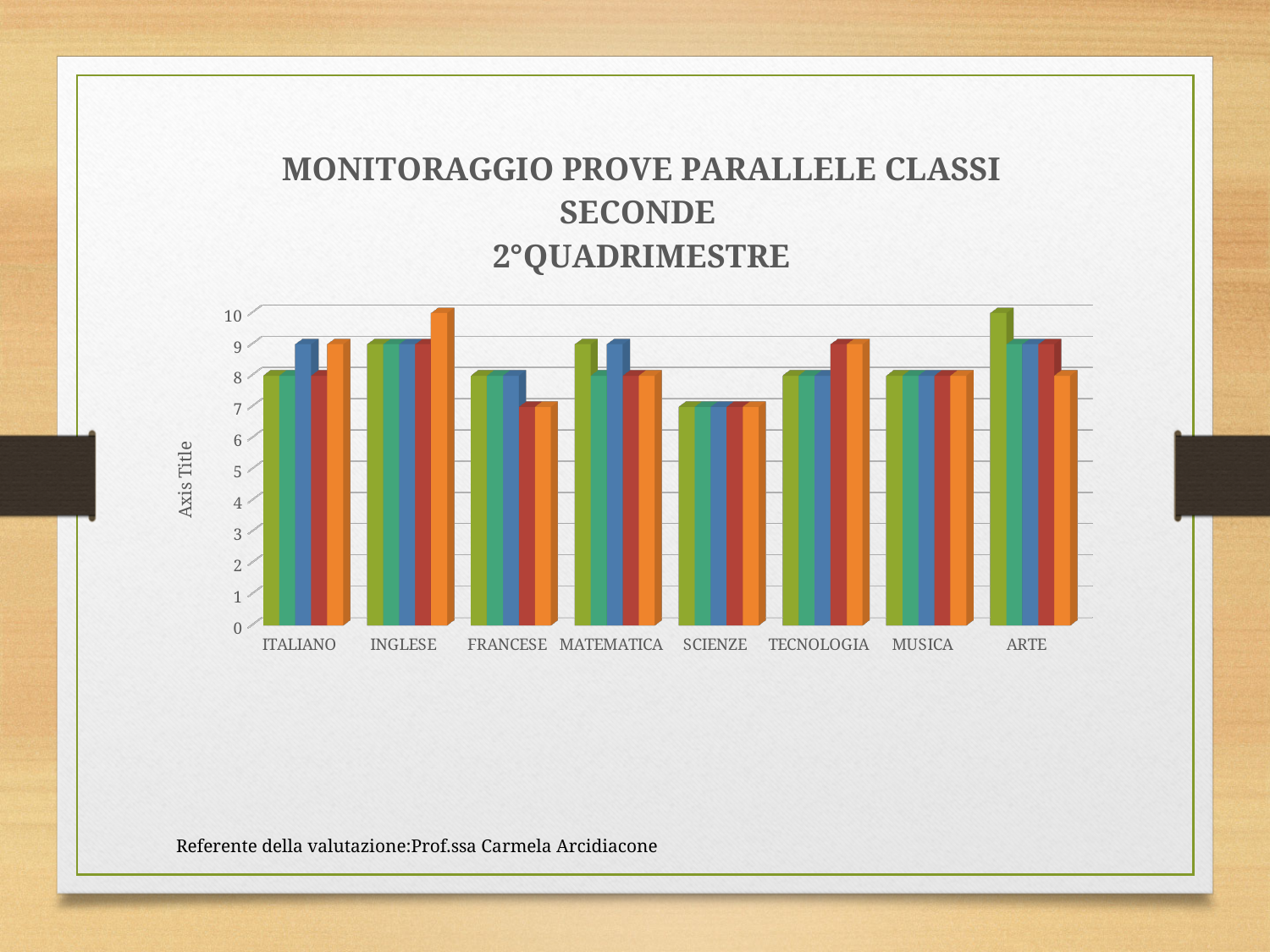
What is the title of the chart? MONITORAGGIO PROVE PARALLELE CLASSI SECONDE 2°QUADRIMESTRE What is the difference between the orange (last) bar for INGLESE and the orange (last) bar for FRANCESE? 3 How many subject categories are shown on the x axis of the chart? 8 What kind of chart is shown on the slide? Bar chart What label is shown on the vertical axis? Axis Title What is the value of the orange (last) bar for INGLESE? 10 What is the value of the green (first) bar for ARTE? 10 Which subject has the lowest values across all of its bars? SCIENZE What value do all the bars for SCIENZE reach? 7 What value do all the bars for MUSICA reach? 8 Is the orange (last) bar for FRANCESE greater or less than 8? less How many bars are plotted for each subject category? 5